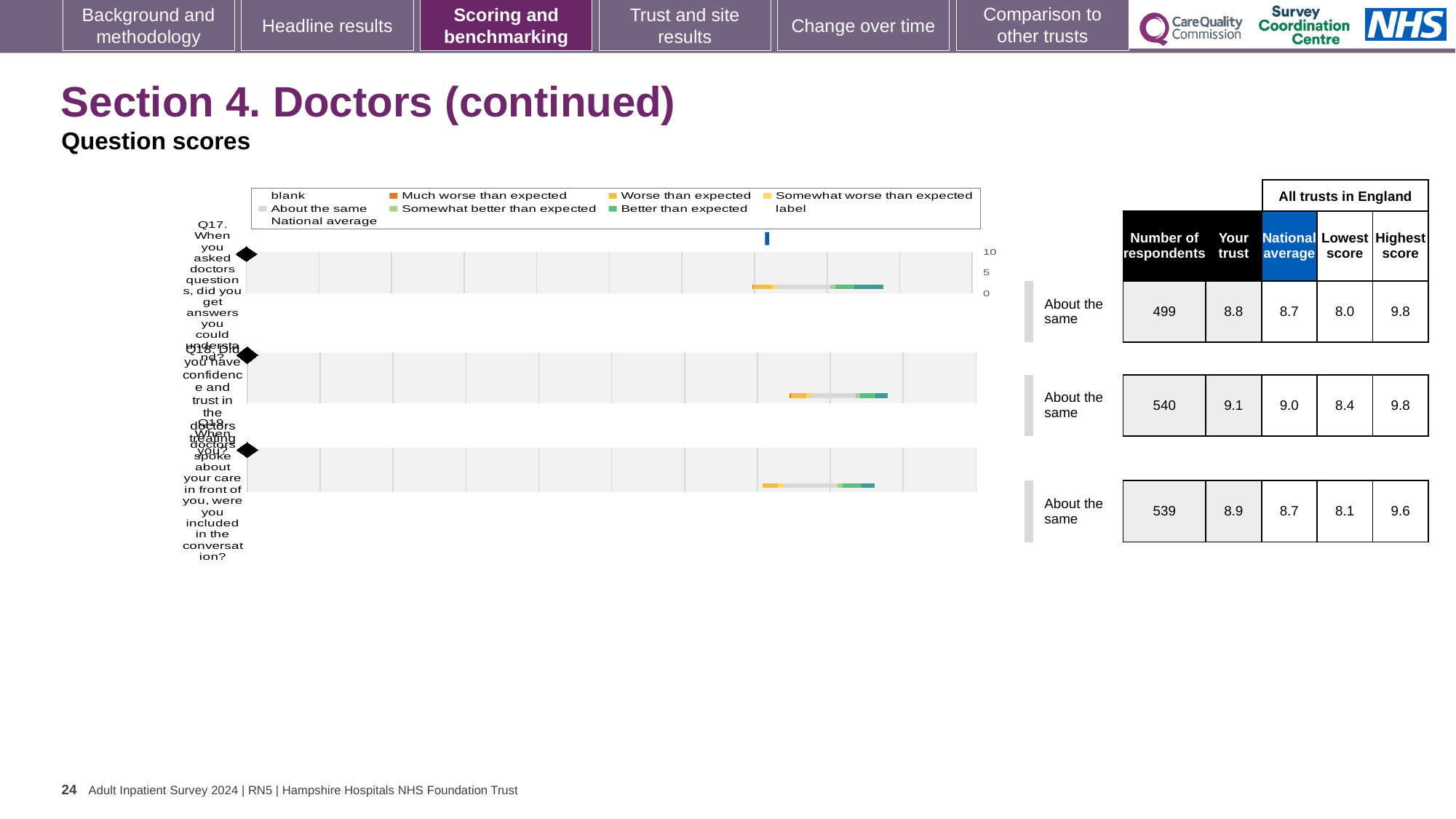
Which question has the highest 'Your trust' score? Q18 What benchmark category is shown next to each of the three questions on the chart? About the same Which is larger, the 'Your trust' score for Q17 or for Q19? Q19 Which question has the lowest number of respondents? Q17 How many questions (categories) are plotted on the chart? 3 What is the difference between the 'Your trust' score and the national average for Q18? 0.1 What is the highest value shown on the chart's score axis? 10 What is the national average score for Q18 (Did you have confidence and trust in the doctors treating you)? 9.0 What kind of chart is used to show the question scores for Q17, Q18 and Q19? bar chart What is the 'Your trust' score for Q17 (When you asked doctors questions, did you get answers you could understand)? 8.8 How many respondents answered Q19 (When doctors spoke about your care in front of you, were you included in the conversation)? 539 Is the 'Your trust' score for Q17 greater or less than 5 on the chart's axis? greater